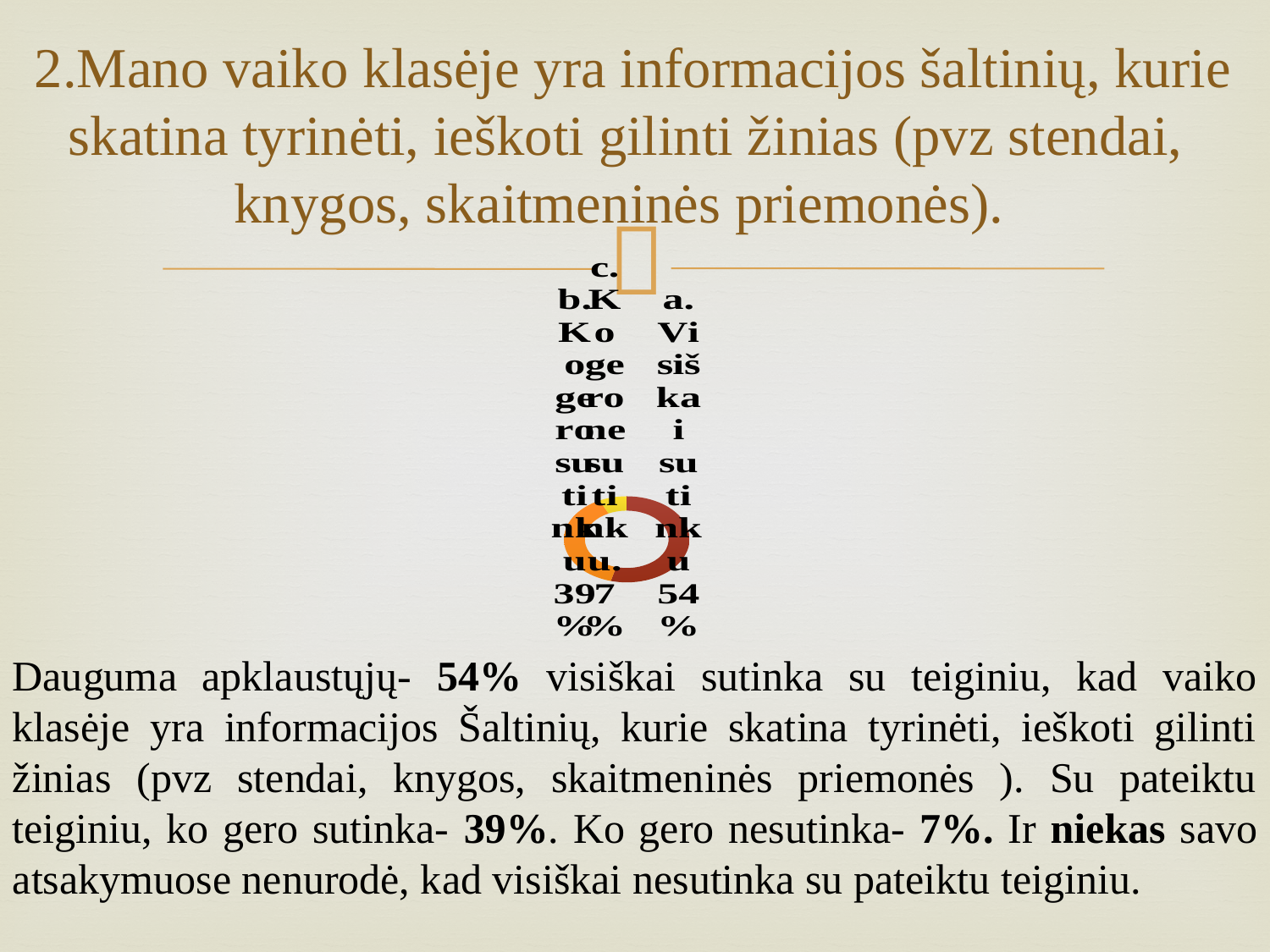
Is the slice for "a. Visiškai sutinku" more or less than half of the doughnut chart? more How many slices does the doughnut chart have? 3 What kind of chart is shown on the slide? Doughnut (pie) chart What percentage is shown for the slice labelled "a. Visiškai sutinku"? 54% What share of the doughnut chart does "a. Visiškai sutinku" take? 54% Which slice of the doughnut chart is the largest? a. Visiškai sutinku